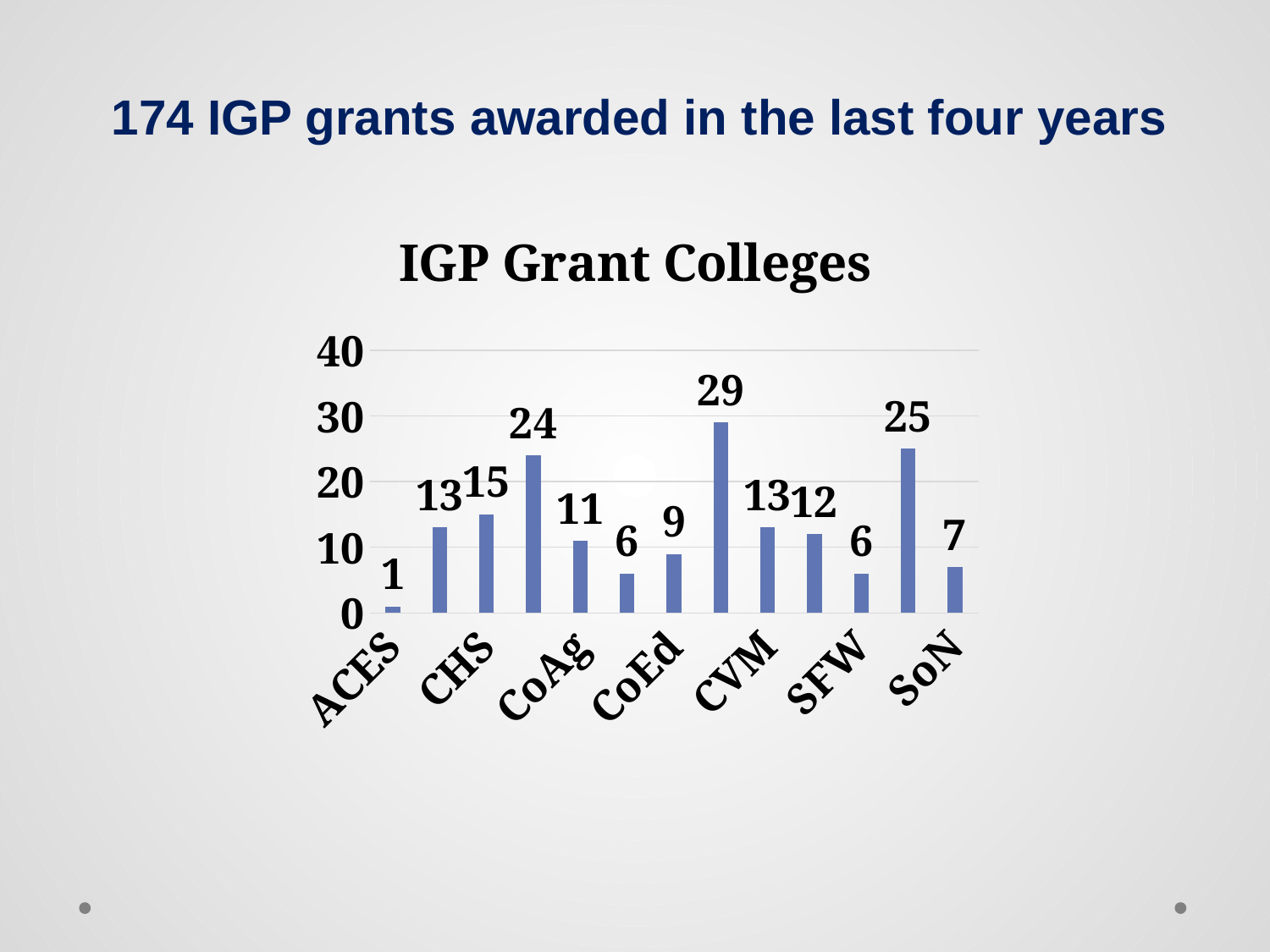
What is the lowest value shown on any bar in the chart? 1 What is the maximum value shown on the vertical axis? 40 What is the highest value shown on any bar in the chart? 29 What is the title of the chart? IGP Grant Colleges What is the difference between the highest bar value (29) and the lowest bar value (1)? 28 What type of chart is shown on the slide? bar chart What is the value for SoN? 7 What is the value for ACES? 1 What is the difference between the values for SoN and ACES? 6 Which has a larger value, ACES or SoN? SoN How many bars are plotted in the chart? 13 Is the highest bar value in the chart greater or less than 30? less